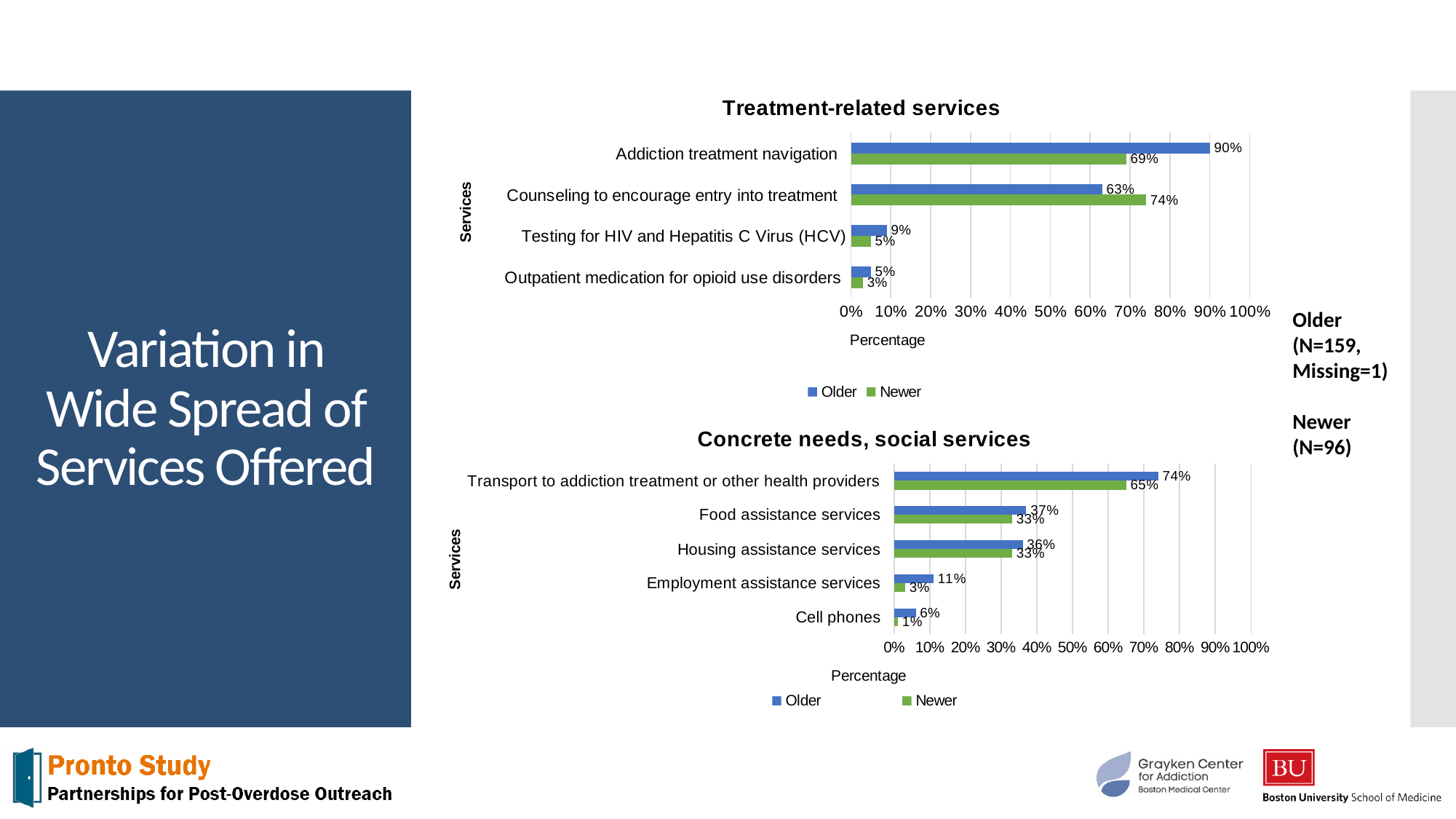
In the 'Treatment-related services' chart, which category has the highest Older value? Addiction treatment navigation In the 'Treatment-related services' chart, what is the difference between the Older and Newer values for Addiction treatment navigation? 21% In the 'Concrete needs, social services' chart, what is the difference between the Older and Newer values for Food assistance services? 4% In the 'Treatment-related services' chart, for Counseling to encourage entry into treatment, which is larger: the Older or the Newer value? Newer How many categories are shown in the 'Concrete needs, social services' chart? 5 In the 'Concrete needs, social services' chart, which category has the lowest Newer value? Cell phones In the 'Treatment-related services' chart, what is the Older value for Addiction treatment navigation? 90% In the 'Treatment-related services' chart, what is the Newer value for Counseling to encourage entry into treatment? 74% In the 'Concrete needs, social services' chart, what is the Older value for Employment assistance services? 11% In the 'Concrete needs, social services' chart, what is the Newer value for Transport to addiction treatment or other health providers? 65% In the 'Treatment-related services' chart, which category has the lowest Newer value? Outpatient medication for opioid use disorders What type of chart is the 'Treatment-related services' chart? Bar chart